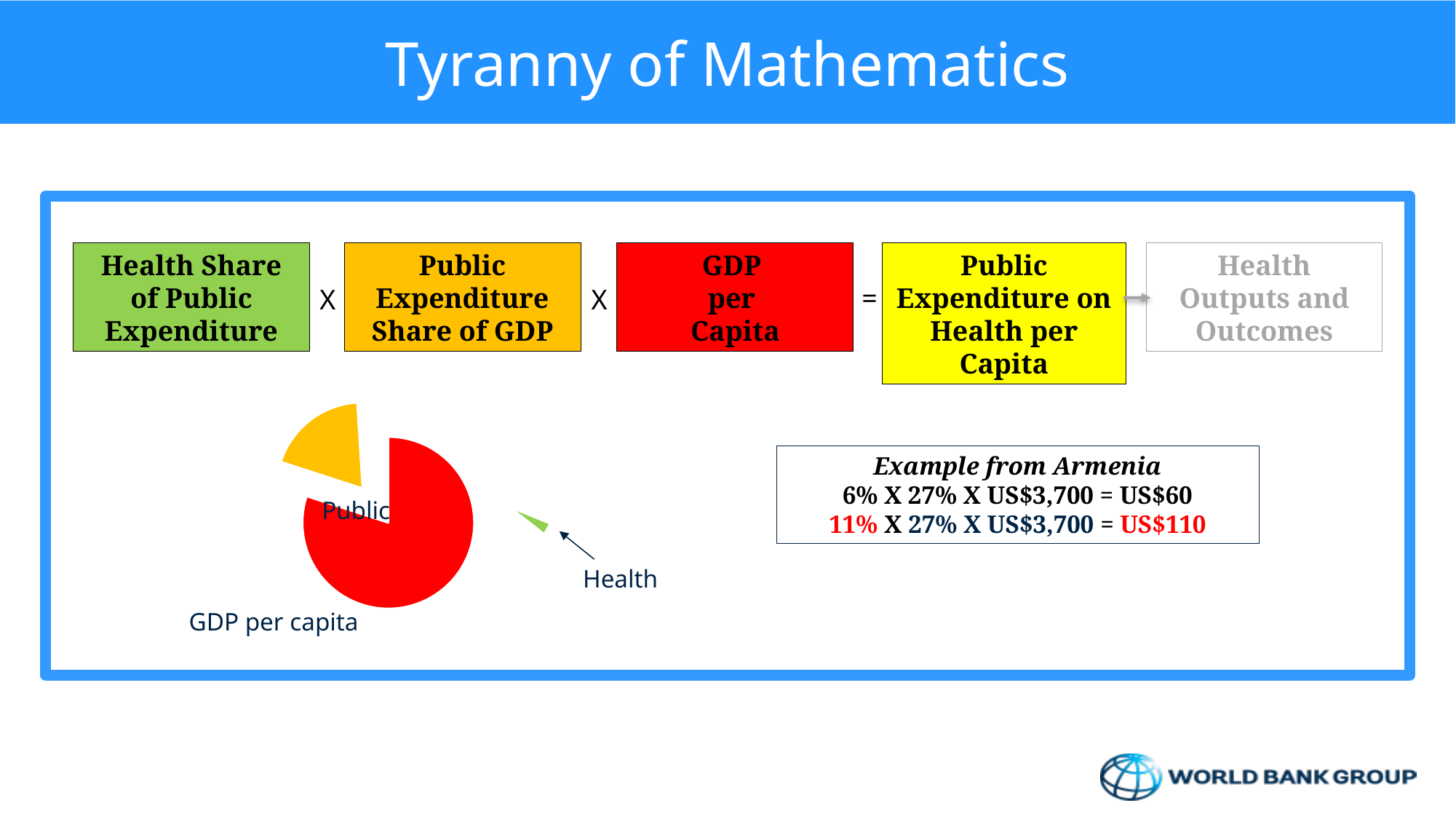
What colour is the GDP per capita slice in the pie chart? red In the pie chart, which slice is larger, GDP per capita or Public? GDP per capita What colour is the Health slice in the pie chart? green What kind of chart is shown on the slide? pie chart Which slice of the pie chart is the smallest? Health In the pie chart, which slice is larger, Public or Health? Public How many slices does the pie chart have? 3 Which slice of the pie chart is the largest? GDP per capita